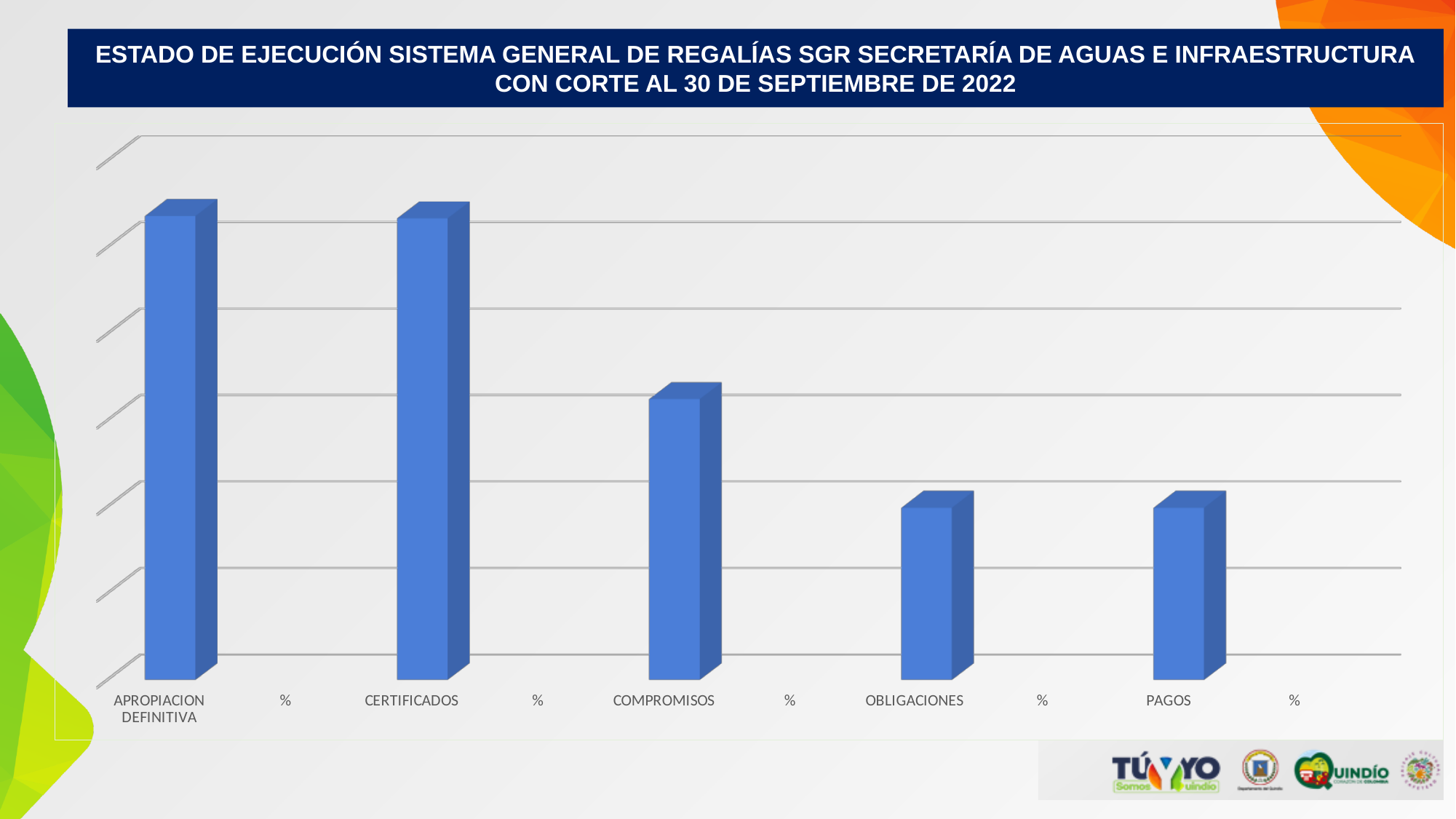
What colour are the bars in the chart? blue Which category has the tallest bar, COMPROMISOS or OBLIGACIONES? COMPROMISOS What kind of chart is shown on the slide? bar chart What cut-off date is stated in the slide title? 30 de septiembre de 2022 How many category labels appear along the x axis of the chart? 10 Which is larger, the bar for CERTIFICADOS or the bar for COMPROMISOS? CERTIFICADOS Do the bar heights generally rise or fall moving from APROPIACION DEFINITIVA on the left to PAGOS on the right? fall How many bars are visibly plotted in the chart? 5 Which is larger, the bar for COMPROMISOS or the bar for OBLIGACIONES? COMPROMISOS